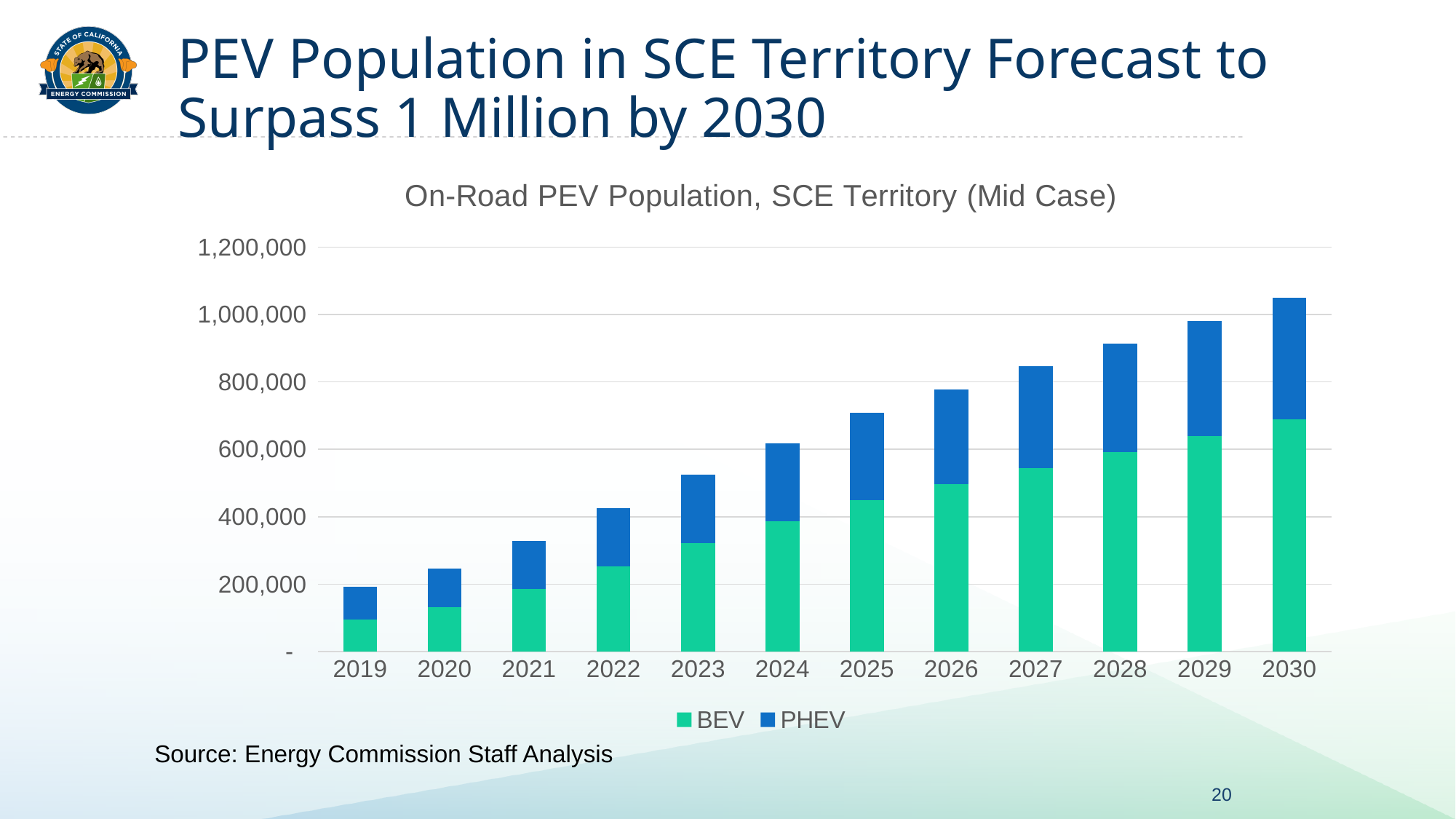
Which year has the lowest total PEV population in the chart? 2019 In 2030, which is larger, the BEV segment or the PHEV segment? BEV What kind of chart is shown on the slide? Stacked bar chart Is the total PEV population for 2030 greater or less than 1,000,000? greater Is the total PEV population for 2021 greater or less than 400,000? less How many series does the chart legend list? 2 How many years are shown on the x axis of the chart? 12 Is the total PEV population for 2027 greater or less than 800,000? greater What is the title of the chart? On-Road PEV Population, SCE Territory (Mid Case) Which year has the highest total PEV population in the chart? 2030 Which series are listed in the chart legend? BEV and PHEV Do the total PEV population values rise or fall from 2019 to 2030? Rise